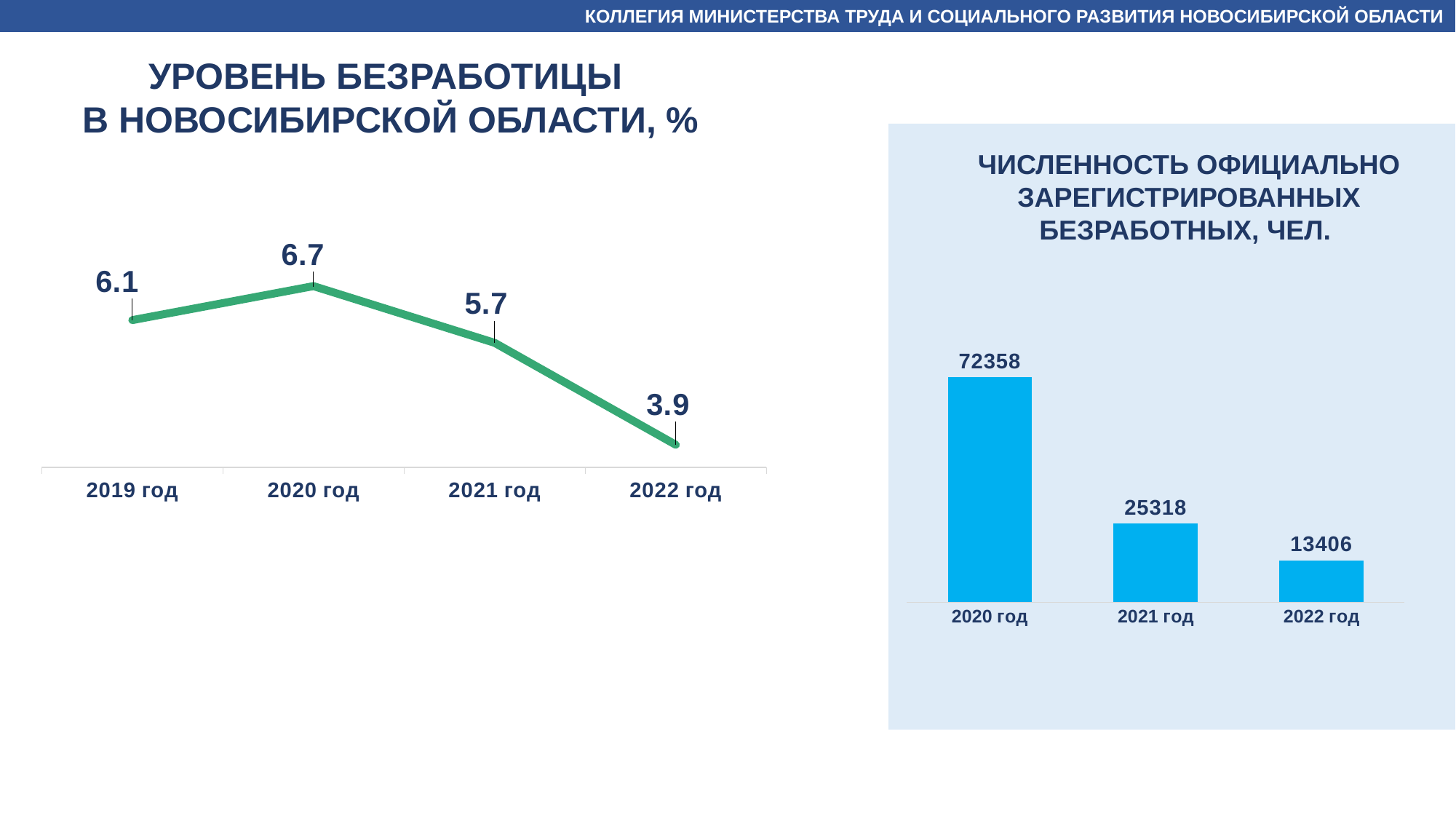
What kind of chart is the chart on the right? bar chart In the line chart on the left, what is the difference between the values for 2020 год and 2022 год? 2.8 In the line chart on the left, which year has the lowest unemployment rate? 2022 год What kind of chart is the chart on the left? line chart In the bar chart on the right, which year has the highest number of registered unemployed? 2020 год In the bar chart on the right (number of officially registered unemployed), what is the value for 2021 год? 25318 In the line chart on the left, what is the value for 2022 год? 3.9 In the line chart on the left, how many data points are plotted? 4 In the line chart on the left, do the values rise or fall from 2020 год to 2022 год? fall In the line chart on the left, which year has the highest unemployment rate? 2020 год In the line chart on the left (unemployment rate in Novosibirsk region, %), what is the value for 2020 год? 6.7 In the bar chart on the right, what is the difference between the values for 2020 год and 2022 год? 58952